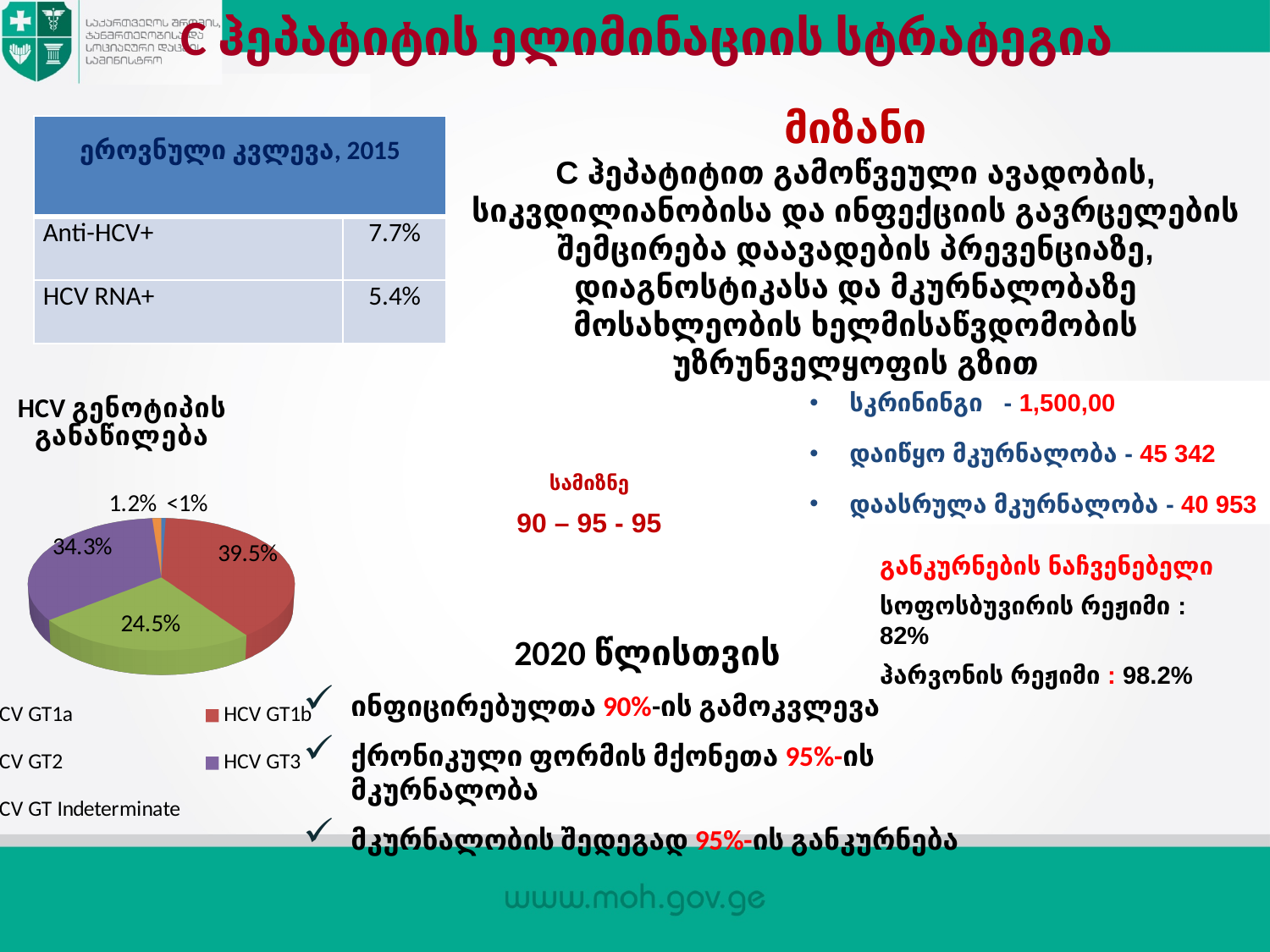
In the HCV genotype distribution pie chart, what percentage is shown on the green slice? 24.5% In the HCV genotype distribution pie chart, what percentage is shown for HCV GT1b? 39.5% In the HCV genotype distribution pie chart, which is larger: HCV GT1b or HCV GT3? HCV GT1b In the HCV genotype distribution pie chart, what percentage is shown for HCV GT3? 34.3% In the HCV genotype distribution pie chart, what is the difference between the HCV GT3 share and the green slice's share? 9.8% How many entries does the legend of the HCV genotype distribution pie chart list? 5 What kind of chart is used to show the HCV genotype distribution (HCV გენოტიპის განაწილება)? pie chart In the HCV genotype distribution pie chart, what is the difference between the HCV GT1b share and the HCV GT3 share? 5.2% In the HCV genotype distribution pie chart, which genotype has the largest slice? HCV GT1b What colour is the HCV GT1b slice in the HCV genotype distribution pie chart? red What colour is the HCV GT3 slice in the HCV genotype distribution pie chart? purple How many slices does the HCV genotype distribution pie chart have? 5